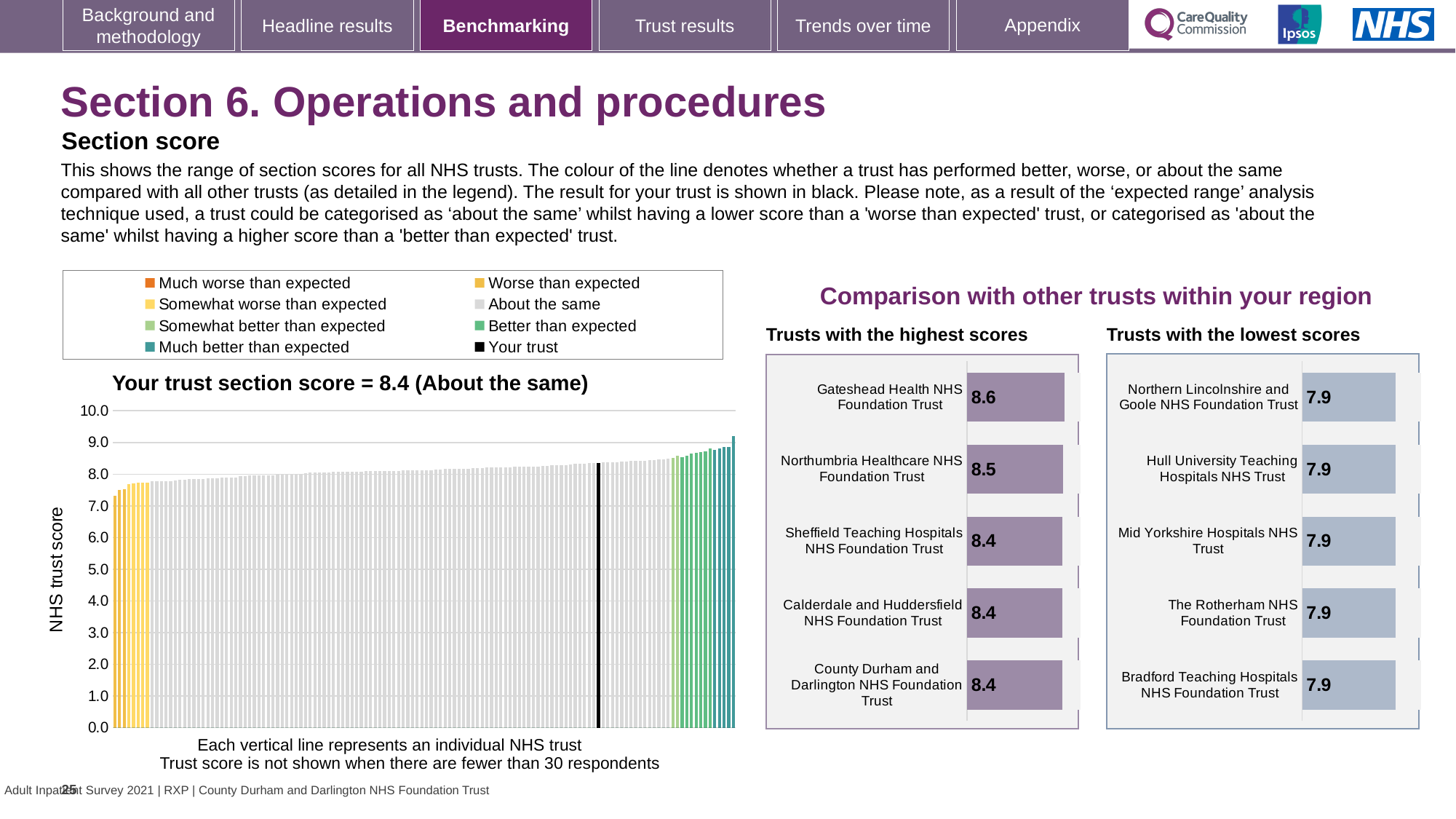
How many trusts are listed in the 'Trusts with the highest scores' chart? 5 In the 'Trusts with the lowest scores' chart, what is the score for Hull University Teaching Hospitals NHS Trust? 7.9 In the 'Trusts with the highest scores' chart, what is the difference between the scores of Gateshead Health NHS Foundation Trust and Northumbria Healthcare NHS Foundation Trust? 0.1 In the 'Trusts with the highest scores' chart, which trust has the highest score? Gateshead Health NHS Foundation Trust What kind of chart is the large chart on the left showing all NHS trusts? Bar chart In the 'Trusts with the highest scores' chart, what is the score for Gateshead Health NHS Foundation Trust? 8.6 In the large chart on the left showing all NHS trusts, what is the section score for your trust? 8.4 What is the difference between the score of Gateshead Health NHS Foundation Trust in the 'Trusts with the highest scores' chart and the score of Bradford Teaching Hospitals NHS Foundation Trust in the 'Trusts with the lowest scores' chart? 0.7 How many trusts are listed in the 'Trusts with the lowest scores' chart? 5 How many entries does the legend above the large chart on the left list? 8 In the large chart on the left showing all NHS trusts, do the trust scores rise or fall from left to right? Rise In the 'Trusts with the highest scores' chart, which has the larger score: Gateshead Health NHS Foundation Trust or Sheffield Teaching Hospitals NHS Foundation Trust? Gateshead Health NHS Foundation Trust